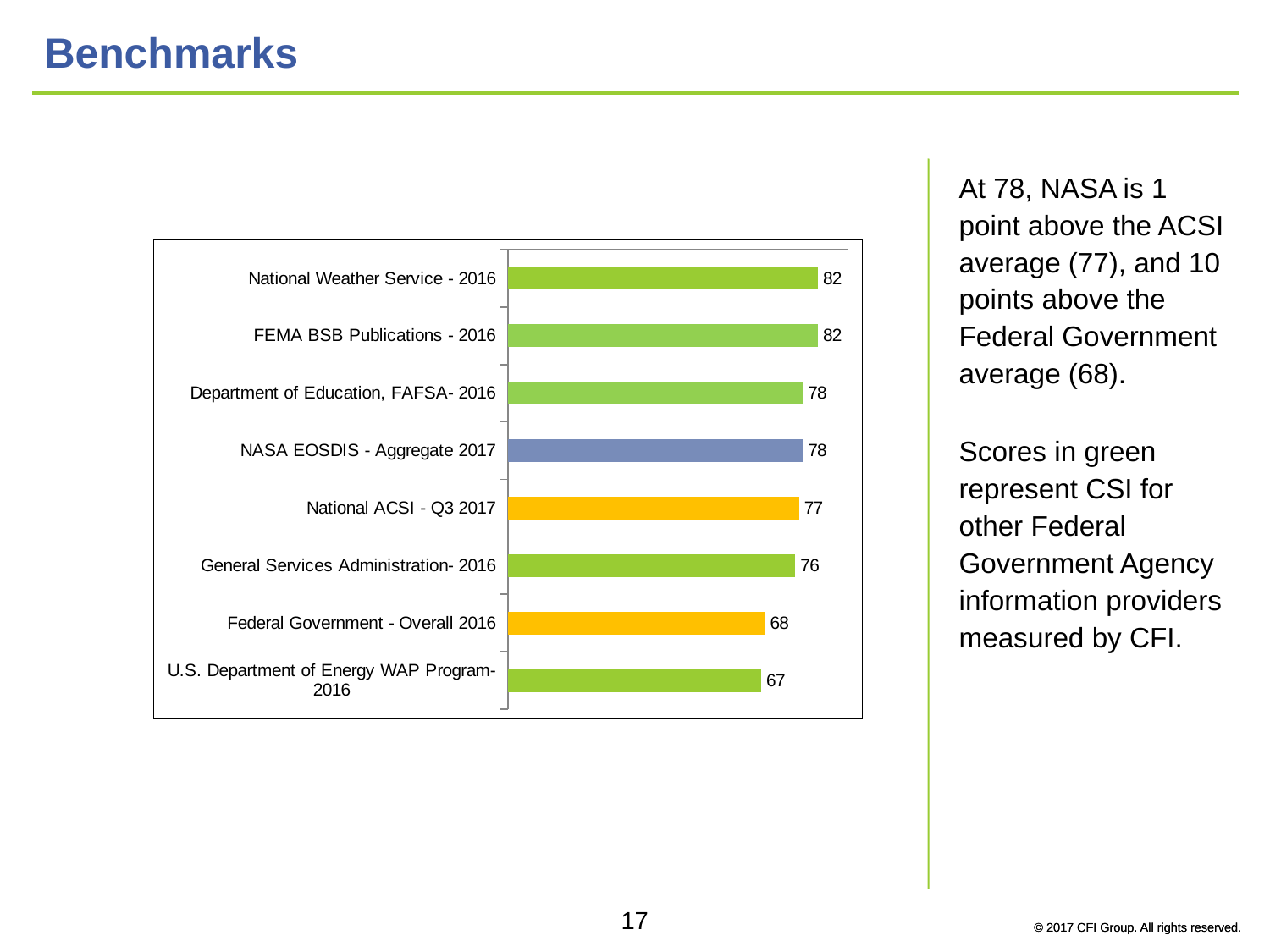
What colour is the bar for NASA EOSDIS - Aggregate 2017? Blue What is the value for NASA EOSDIS - Aggregate 2017? 78 How many categories are shown on the chart? 8 What is the value for General Services Administration- 2016? 76 Which is larger, the value for FEMA BSB Publications - 2016 or the value for General Services Administration- 2016? FEMA BSB Publications - 2016 What is the difference between National Weather Service - 2016 and U.S. Department of Energy WAP Program- 2016? 15 What is the highest value shown on the chart? 82 What is the difference between NASA EOSDIS - Aggregate 2017 and Federal Government - Overall 2016? 10 Which category has the lowest value? U.S. Department of Energy WAP Program- 2016 What is the value for Federal Government - Overall 2016? 68 What kind of chart is shown on the slide? Bar chart What is the value for National ACSI - Q3 2017? 77